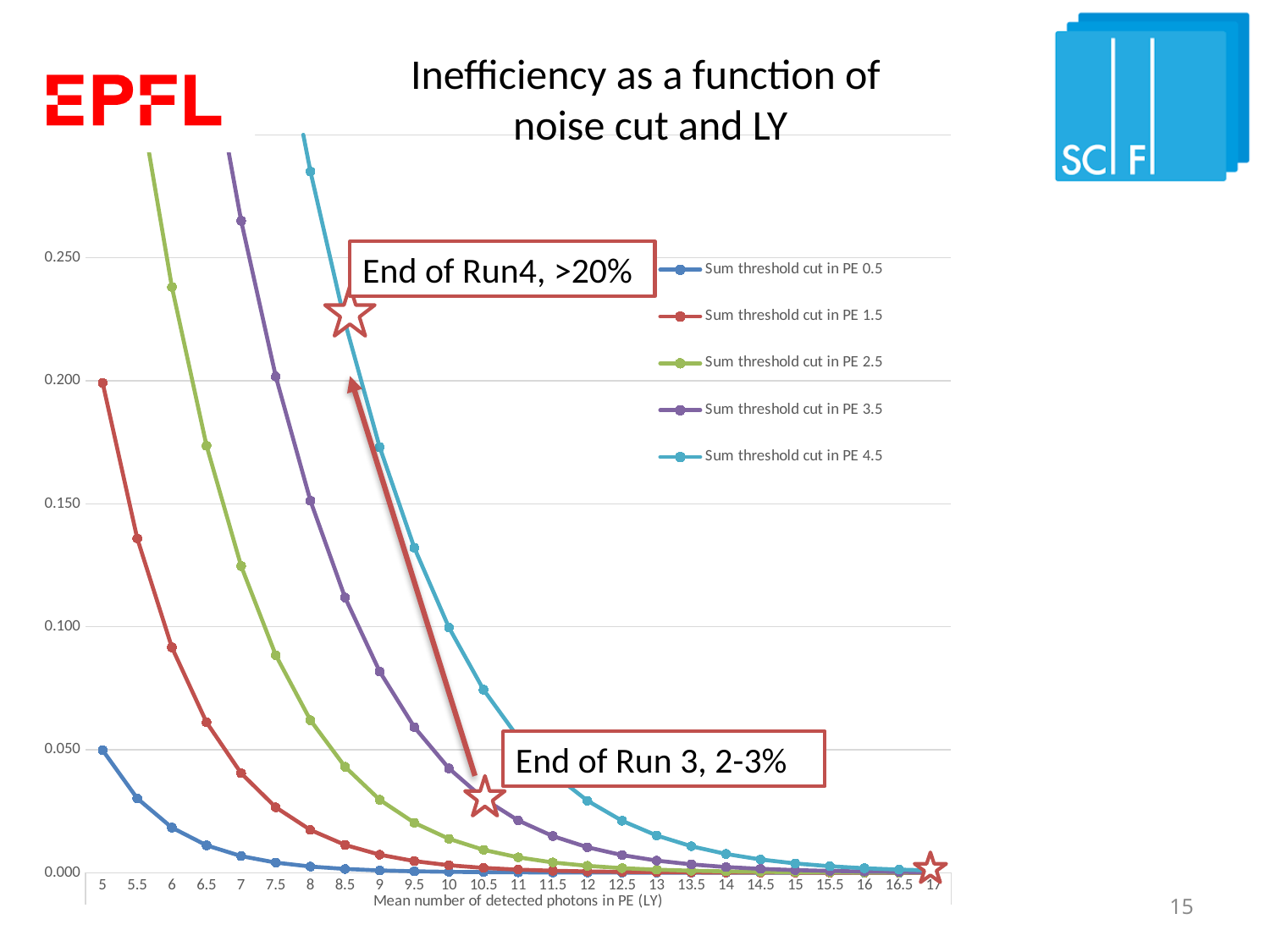
What is the label of the x axis? Mean number of detected photons in PE (LY) Is the value for 'Sum threshold cut in PE 1.5' at LY 6 greater or less than 0.100? less Is the value for 'Sum threshold cut in PE 3.5' at LY 9 greater or less than 0.100? less Do the values of the 'Sum threshold cut in PE 4.5' series rise or fall as the mean number of detected photons increases? fall How many series does the legend list? 5 Which series has the lowest value at LY 8? Sum threshold cut in PE 0.5 What kind of chart is shown on the slide? line chart Is the value for 'Sum threshold cut in PE 4.5' at LY 9 greater or less than 0.150? greater What is the title of the chart? Inefficiency as a function of noise cut and LY At LY 8, which is larger: the value for 'Sum threshold cut in PE 4.5' or for 'Sum threshold cut in PE 0.5'? Sum threshold cut in PE 4.5 How many x-axis tick values are shown on the chart? 25